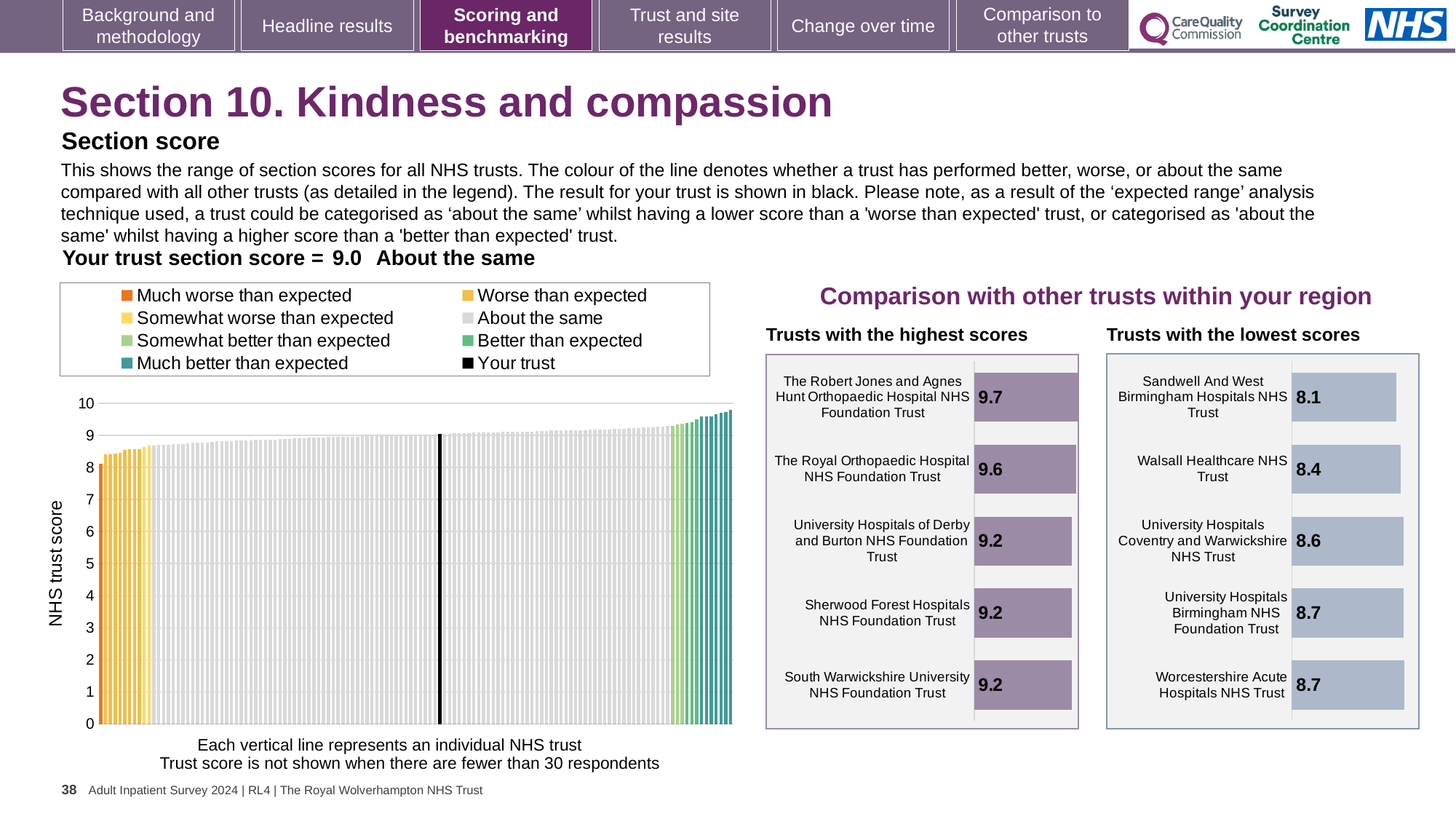
In the 'Trusts with the lowest scores' chart, which has the larger score: Walsall Healthcare NHS Trust or University Hospitals Coventry and Warwickshire NHS Trust? University Hospitals Coventry and Warwickshire NHS Trust In the 'Trusts with the highest scores' chart, which trust has the highest score? The Robert Jones and Agnes Hunt Orthopaedic Hospital NHS Foundation Trust In the 'Trusts with the lowest scores' chart, what is the score for Walsall Healthcare NHS Trust? 8.4 In the 'Trusts with the highest scores' chart, what is the difference between the scores of The Robert Jones and Agnes Hunt Orthopaedic Hospital NHS Foundation Trust and The Royal Orthopaedic Hospital NHS Foundation Trust? 0.1 In the 'NHS trust score' chart on the left, is the value of the rightmost bar greater or less than 9? greater In the 'Trusts with the highest scores' chart, what is the score for The Robert Jones and Agnes Hunt Orthopaedic Hospital NHS Foundation Trust? 9.7 In the 'NHS trust score' chart on the left, do the bar values rise or fall from left to right? rise In the 'Trusts with the highest scores' chart, how many trusts are listed? 5 In the 'NHS trust score' chart on the left, is the value of the leftmost bar greater or less than 9? less In the 'NHS trust score' chart on the left, how many entries does the legend list? 8 In the 'NHS trust score' chart on the left, what kind of chart is shown? bar chart In the 'Trusts with the lowest scores' chart, which trust has the lowest score? Sandwell And West Birmingham Hospitals NHS Trust